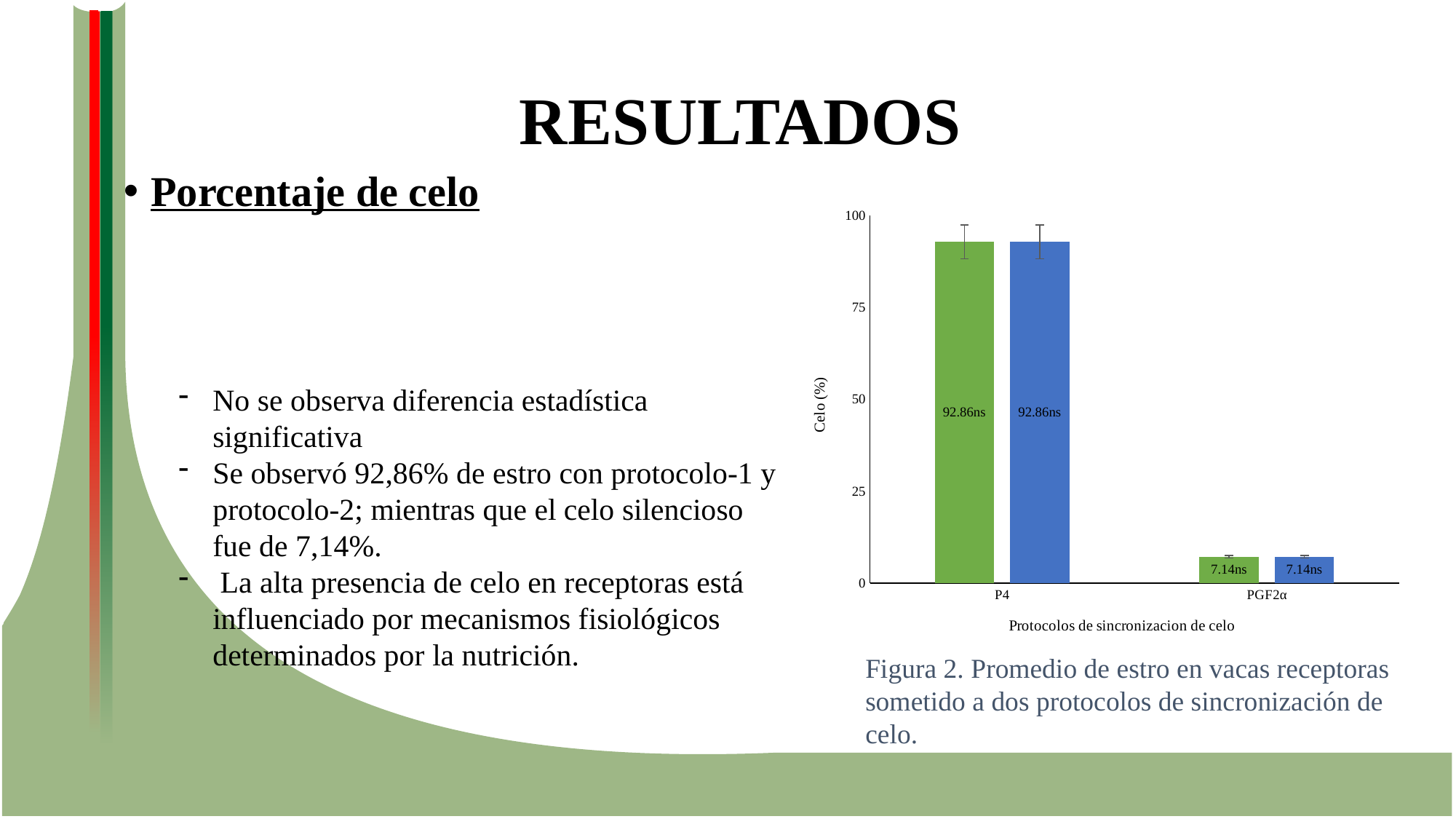
Which protocol on the x axis has the highest bars? P4 What kind of chart is shown on the slide? bar chart What is the data label on the green bar for P4? 92.86ns How many protocol categories are shown on the x axis? 2 What is the title of the x axis of the chart? Protocolos de sincronizacion de celo What is the data label on the blue bar for PGF2α? 7.14ns What is the title of the y axis of the chart? Celo (%) Is the value of the blue bar for P4 greater or less than 75? greater Which is larger: the blue bar for P4 or the blue bar for PGF2α? P4 Is the value of the green bar for PGF2α greater or less than 25? less Which protocol on the x axis has the lowest bars? PGF2α What is the difference between the green bar value for P4 and the green bar value for PGF2α? 85.72